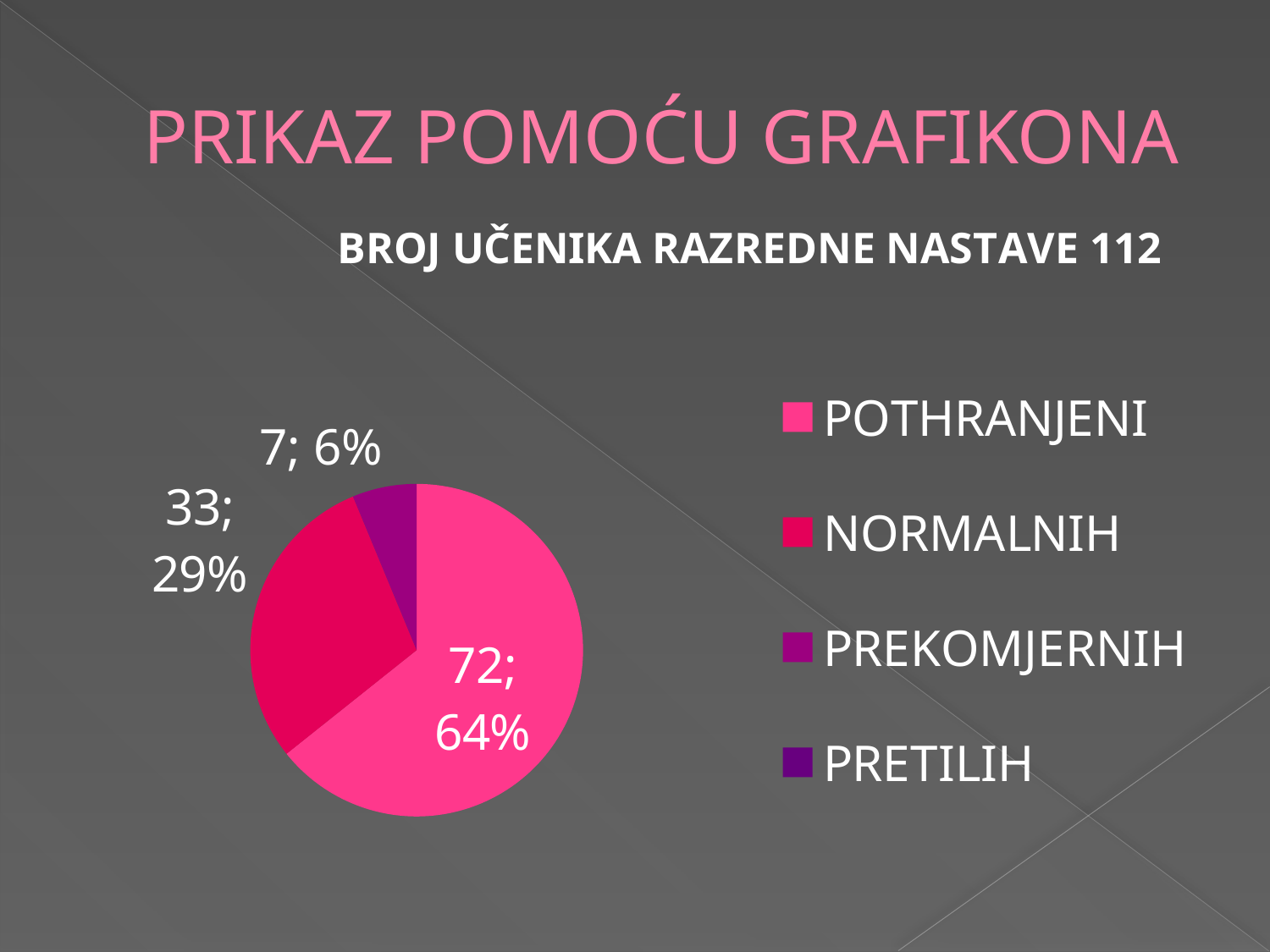
What is the data label on the PREKOMJERNIH slice of the pie chart? 7; 6% What is the difference between the counts for POTHRANJENI and NORMALNIH? 39 What share of the pie does the POTHRANJENI slice represent? 64% Which is larger, the NORMALNIH slice or the PREKOMJERNIH slice? NORMALNIH What is the data label on the POTHRANJENI slice of the pie chart? 72; 64% What is the data label on the NORMALNIH slice of the pie chart? 33; 29% What share of the pie does the NORMALNIH slice represent? 29% How many entries does the legend of the pie chart list? 4 What kind of chart is shown on the slide? pie chart What is the title shown above the pie chart? BROJ UČENIKA RAZREDNE NASTAVE 112 Which of the labelled slices in the pie chart is the smallest? PREKOMJERNIH Which category has the largest slice in the pie chart? POTHRANJENI